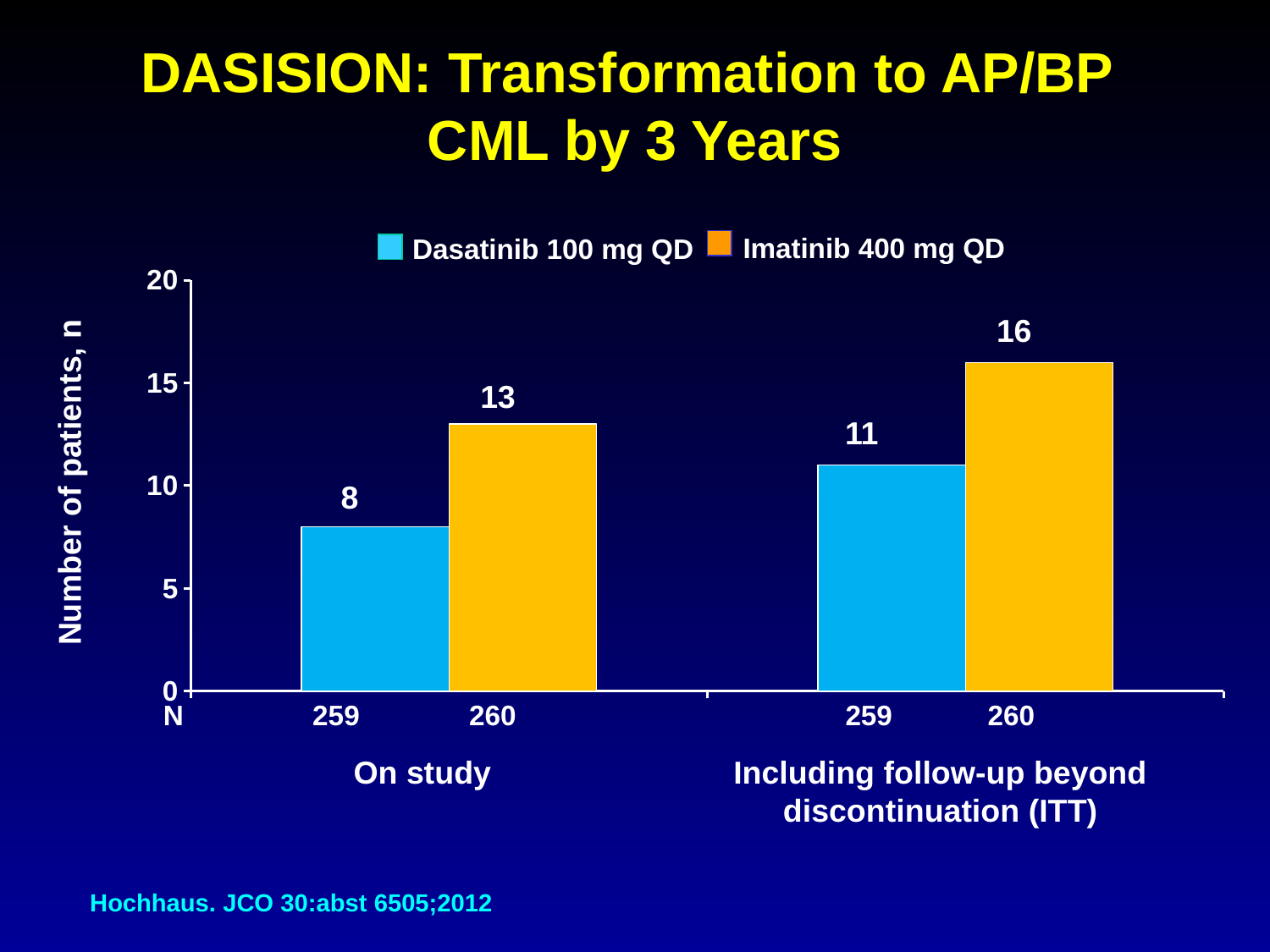
What is the number of patients for Imatinib 400 mg QD in the On study group? 13 What is the label of the y axis? Number of patients, n What is the number of patients for Dasatinib 100 mg QD in the Including follow-up beyond discontinuation (ITT) group? 11 What is the number of patients for Dasatinib 100 mg QD in the On study group? 8 In the ITT group, which treatment has more patients with transformation, Dasatinib 100 mg QD or Imatinib 400 mg QD? Imatinib 400 mg QD Which bar has the lowest number of patients? Dasatinib 100 mg QD, On study Which bar has the highest number of patients? Imatinib 400 mg QD, Including follow-up beyond discontinuation (ITT) What is the number of patients for Imatinib 400 mg QD in the Including follow-up beyond discontinuation (ITT) group? 16 What is the difference in number of patients between Imatinib 400 mg QD and Dasatinib 100 mg QD in the ITT group? 5 What kind of chart is shown on the slide? Bar chart What is the difference in number of patients between Imatinib 400 mg QD and Dasatinib 100 mg QD in the On study group? 5 How many series does the legend list? 2